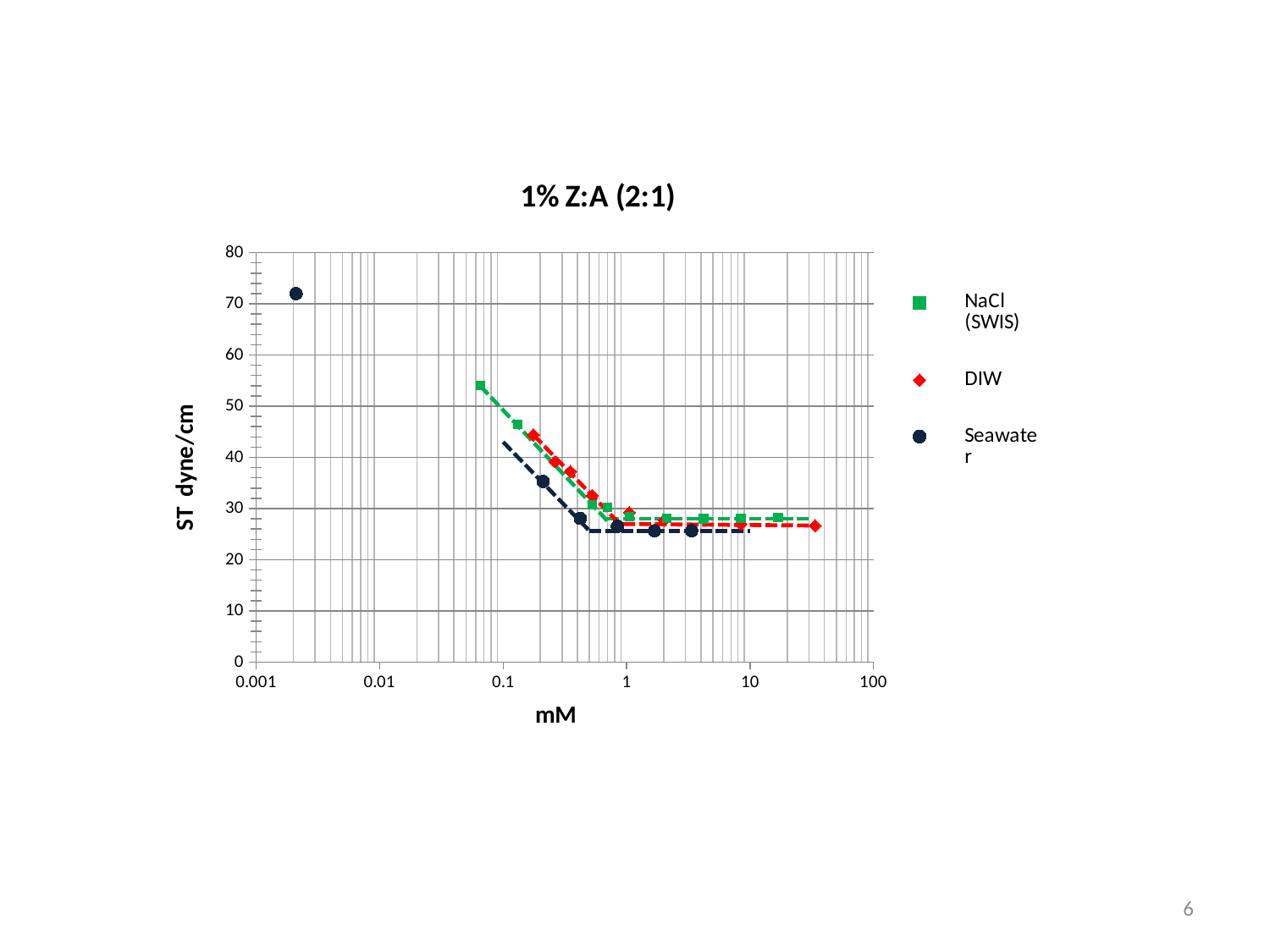
Which series has the lowest ST values at concentrations around 3 mM? Seawater What is the title of the chart? 1% Z:A (2:1) Which series has a data point at the lowest concentration on the chart? Seawater Are the Seawater values between 1 and 10 mM greater or less than 30 dyne/cm? less Is the value of the Seawater point at about 0.002 mM greater or less than 60 dyne/cm? greater Is the value of the first NaCl (SWIS) point (at about 0.06 mM) greater or less than 50 dyne/cm? greater How many series does the legend list? 3 How do the ST values change as concentration increases from 0.1 mM to 1 mM? They fall Which series has a data point at the highest concentration on the chart? DIW What kind of chart is shown on the slide? Scatter chart What is the label of the x axis? mM